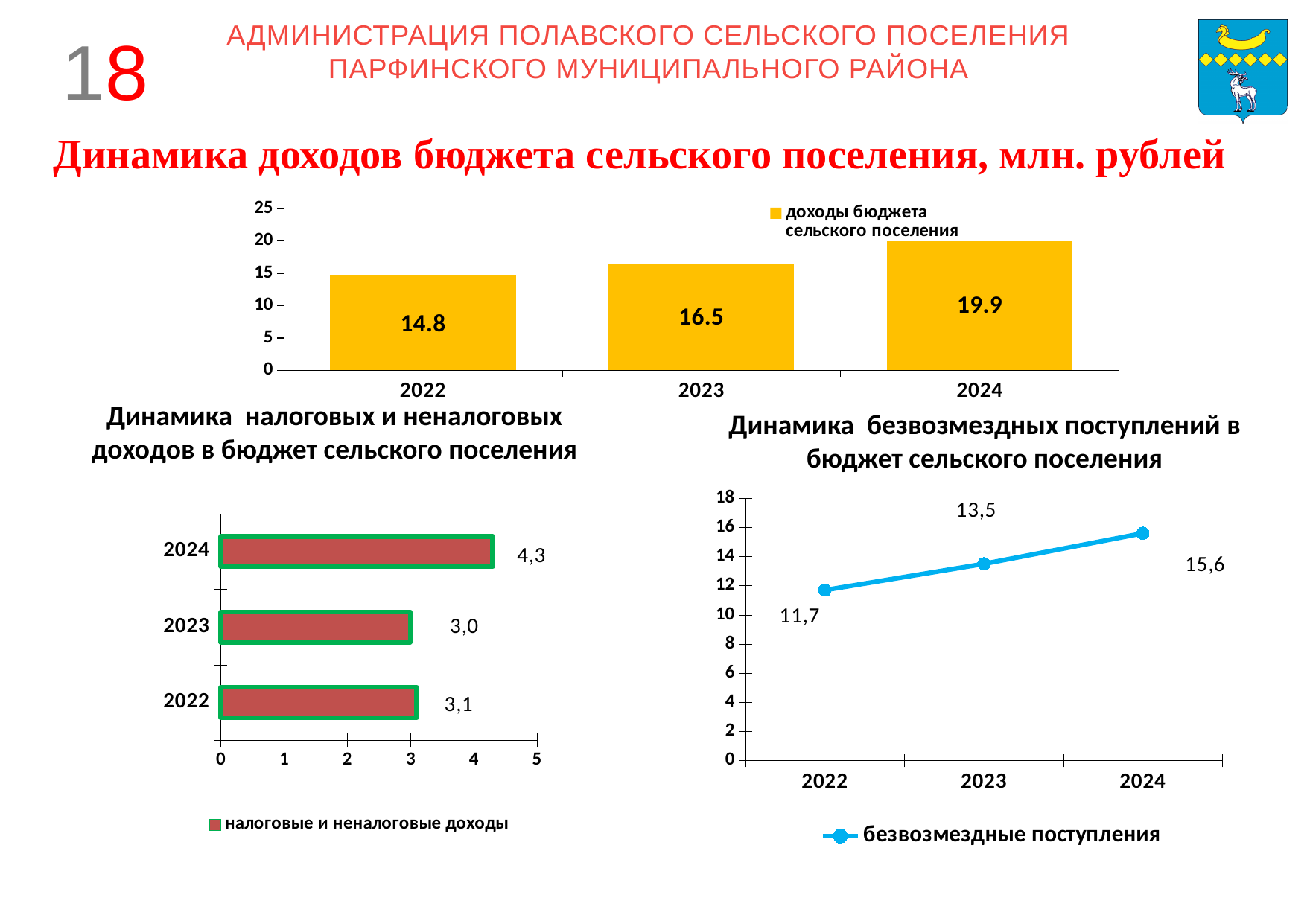
In the bottom-left chart (Динамика налоговых и неналоговых доходов), what is the value for 2023? 3,0 In the top chart (доходы бюджета сельского поселения), what is the difference between the 2024 and 2022 values? 5.1 In the top chart (доходы бюджета сельского поселения), what is the value for 2024? 19.9 In the bottom-right chart (Динамика безвозмездных поступлений), what is the value for 2022? 11,7 In the bottom-left chart (Динамика налоговых и неналоговых доходов), what kind of chart is shown? bar chart In the top chart (доходы бюджета сельского поселения), which year has the lowest value? 2022 In the top chart (доходы бюджета сельского поселения), do the values rise or fall from 2022 to 2024? rise In the bottom-right chart (Динамика безвозмездных поступлений), what kind of chart is shown? line chart In the bottom-left chart (Динамика налоговых и неналоговых доходов), how many years are shown? 3 In the bottom-left chart (Динамика налоговых и неналоговых доходов), which year has the highest value? 2024 In the bottom-right chart (Динамика безвозмездных поступлений), which is larger, the value for 2023 or the value for 2024? 2024 In the bottom-right chart (Динамика безвозмездных поступлений), what is the difference between the 2024 and 2023 values? 2,1